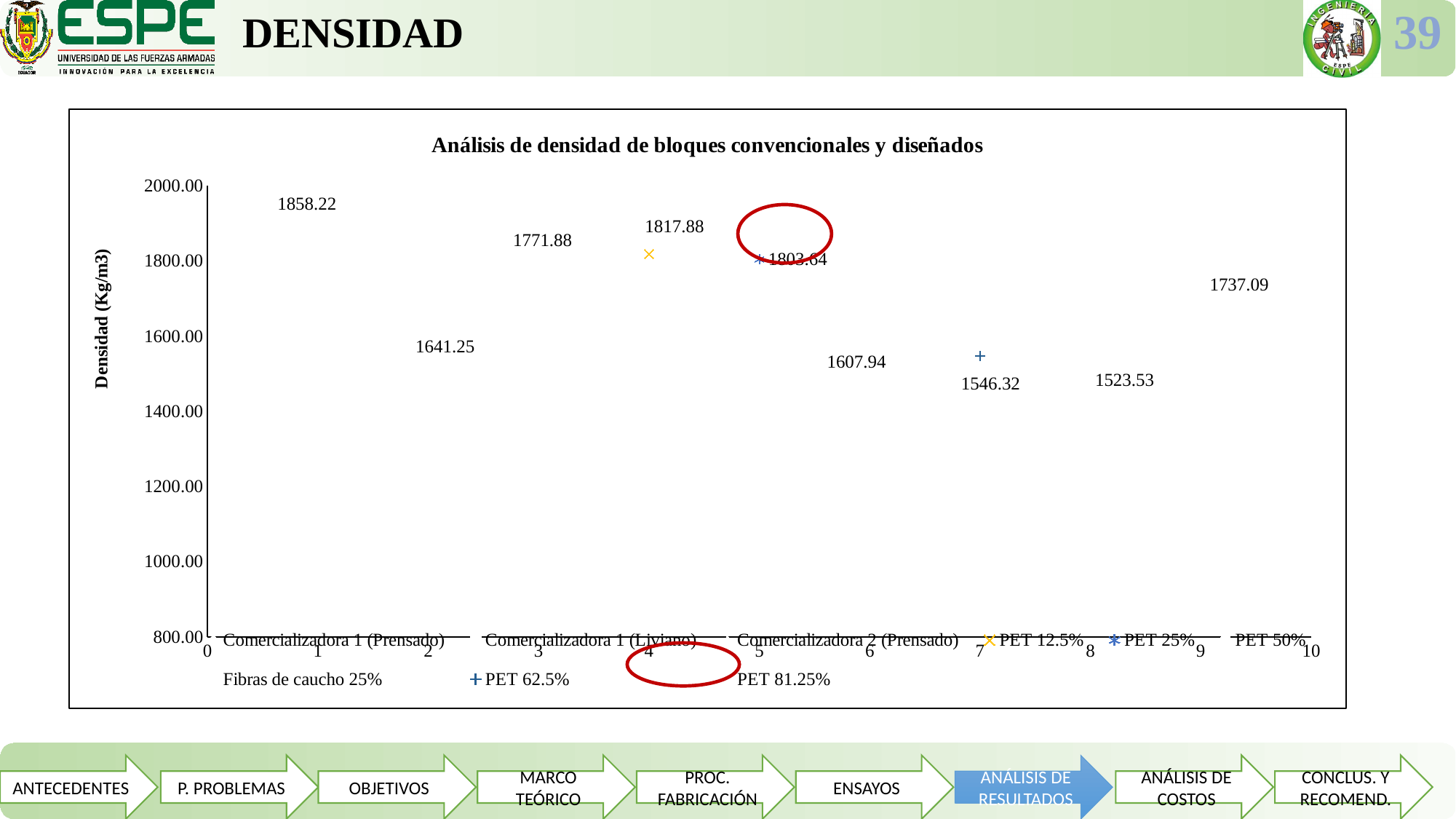
Which has a higher density, PET 12.5% or PET 62.5%? PET 12.5% What is the density value for PET 12.5%? 1817.88 How many data points are plotted on the chart? 9 What is the highest density value labelled on the chart? 1858.22 What is the lowest density value labelled on the chart? 1523.53 What is the difference between the density of PET 12.5% and PET 25%? 14.24 What is the density value for PET 25%? 1803.64 What is the label of the vertical axis? Densidad (Kg/m3) What kind of chart is shown on the slide? scatter chart What is the density value for PET 62.5%? 1546.32 What is the title of the chart? Análisis de densidad de bloques convencionales y diseñados How many series does the chart legend list? 9